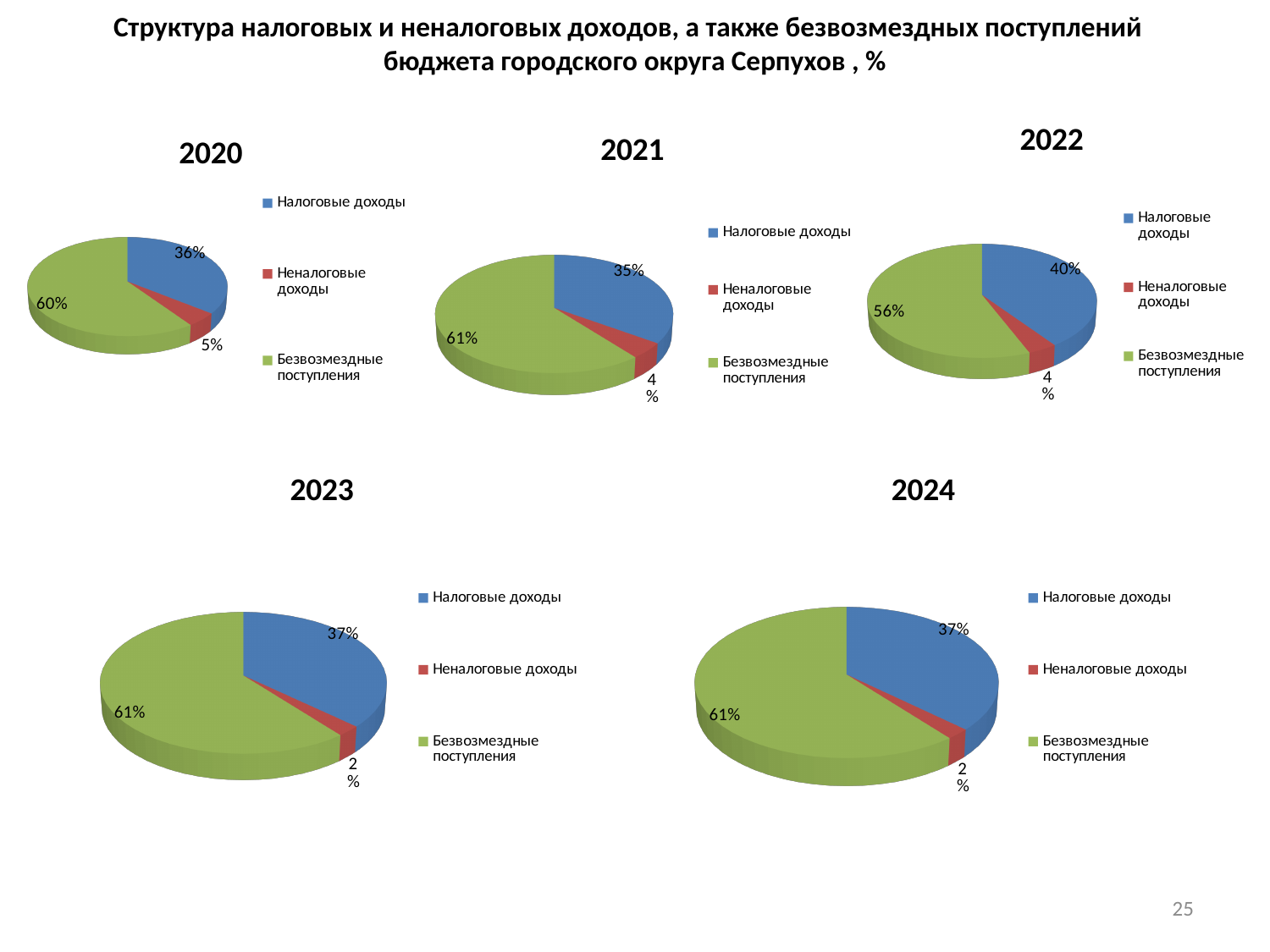
In the 2022 pie chart, what is the difference between Безвозмездные поступления and Налоговые доходы? 16% In the 2023 pie chart, what share is Неналоговые доходы? 2% In the 2020 pie chart, what share is Неналоговые доходы? 5% In the 2024 pie chart, which category has the largest slice? Безвозмездные поступления In the 2021 pie chart, what share is Безвозмездные поступления? 61% How many categories does the legend of the 2023 chart list? 3 In the 2020 pie chart, what share is Налоговые доходы? 36% What type of chart is used for 2020? Pie chart In the 2022 pie chart, which category has the smallest slice? Неналоговые доходы How many pie charts are shown on the slide? 5 Which is larger in the 2021 pie chart: Налоговые доходы or Безвозмездные поступления? Безвозмездные поступления In the 2022 pie chart, what share is Налоговые доходы? 40%